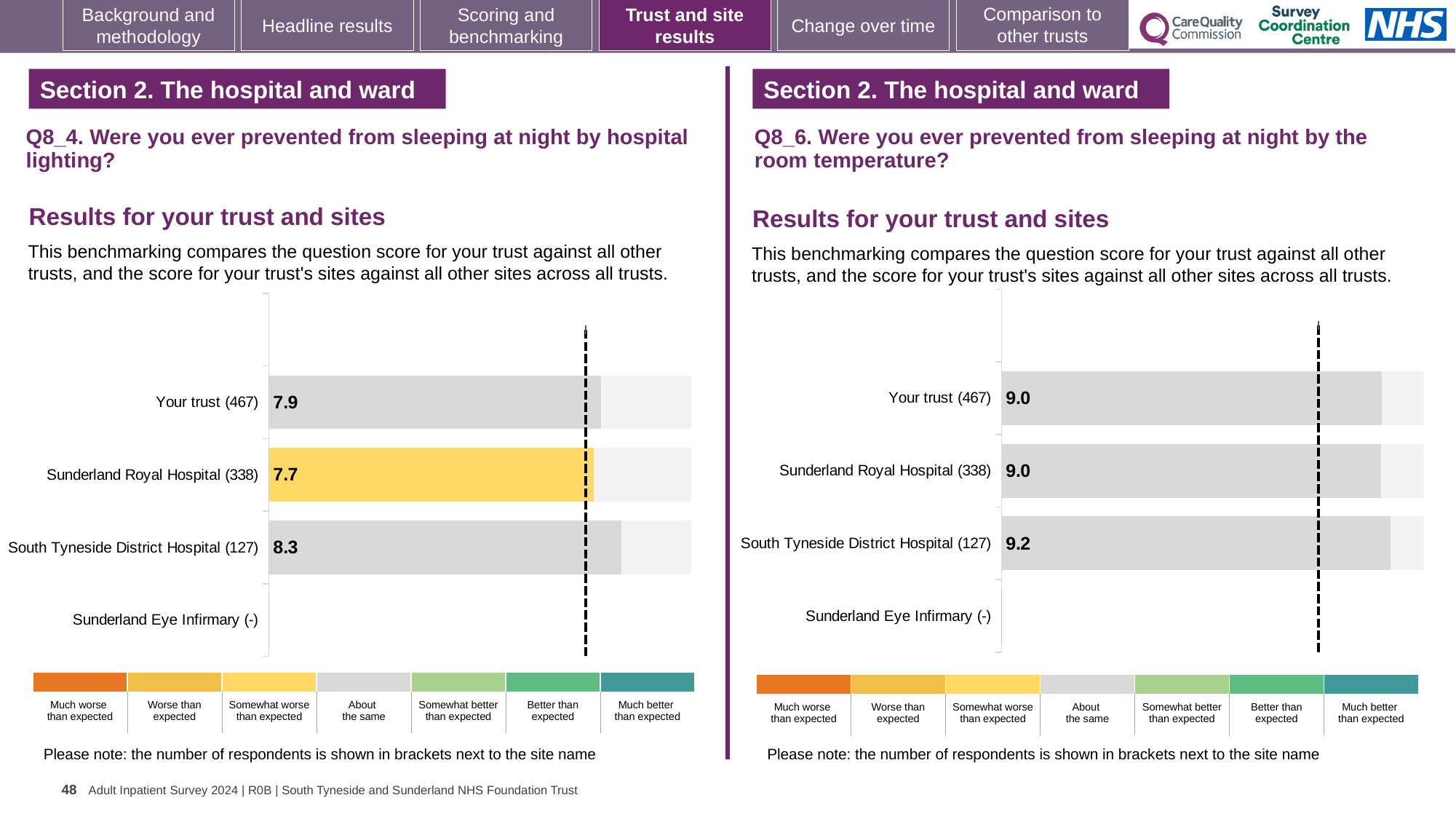
On the Q8_4 hospital lighting chart, which site with a score shown has the lowest score? Sunderland Royal Hospital (338) Is the score for Your trust higher on the Q8_4 hospital lighting chart or the Q8_6 room temperature chart? Q8_6 room temperature chart On the Q8_4 hospital lighting chart, which site has the highest score? South Tyneside District Hospital (127) On the Q8_6 room temperature chart, what is the score for Your trust (467)? 9.0 On the Q8_6 room temperature chart, what is the score for South Tyneside District Hospital (127)? 9.2 How many rows (trust and sites) are listed on the Q8_4 hospital lighting chart? 4 On the Q8_4 hospital lighting chart, what is the score for Your trust (467)? 7.9 On the Q8_6 room temperature chart, which site has the highest score? South Tyneside District Hospital (127) On the Q8_6 room temperature chart, what is the difference between the scores for South Tyneside District Hospital and Your trust? 0.2 What kind of chart is used on the Q8_6 room temperature chart? Bar chart On the Q8_4 hospital lighting chart, what is the difference between the scores for South Tyneside District Hospital and Sunderland Royal Hospital? 0.6 On the Q8_4 hospital lighting chart, what is the score for Sunderland Royal Hospital (338)? 7.7